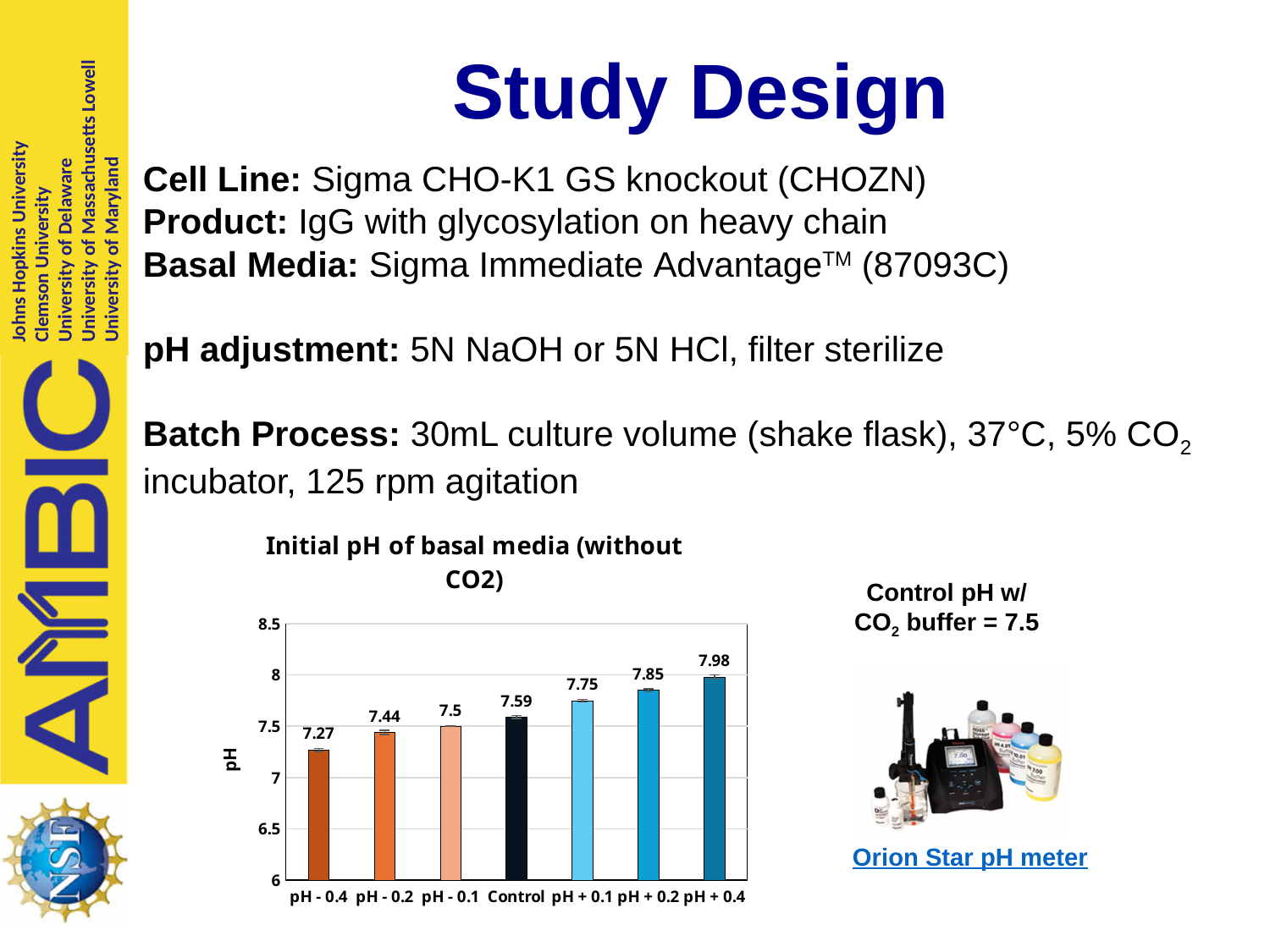
How many categories are shown on the x axis of the chart? 7 What is the title of the chart? Initial pH of basal media (without CO2) Which category has the highest value in the chart? pH + 0.4 What is the value for Control in the chart? 7.59 What is the value for pH + 0.2 in the chart? 7.85 Which category has the lowest value in the chart? pH - 0.4 Is the value for pH + 0.4 greater or less than 8? less What kind of chart is shown on the slide? bar chart What is the difference between the values for pH + 0.4 and Control? 0.39 What is the value for pH - 0.4 in the chart? 7.27 Which is larger, the value for pH + 0.1 or the value for pH - 0.1? pH + 0.1 What is the difference between the values for pH - 0.1 and pH - 0.2? 0.06